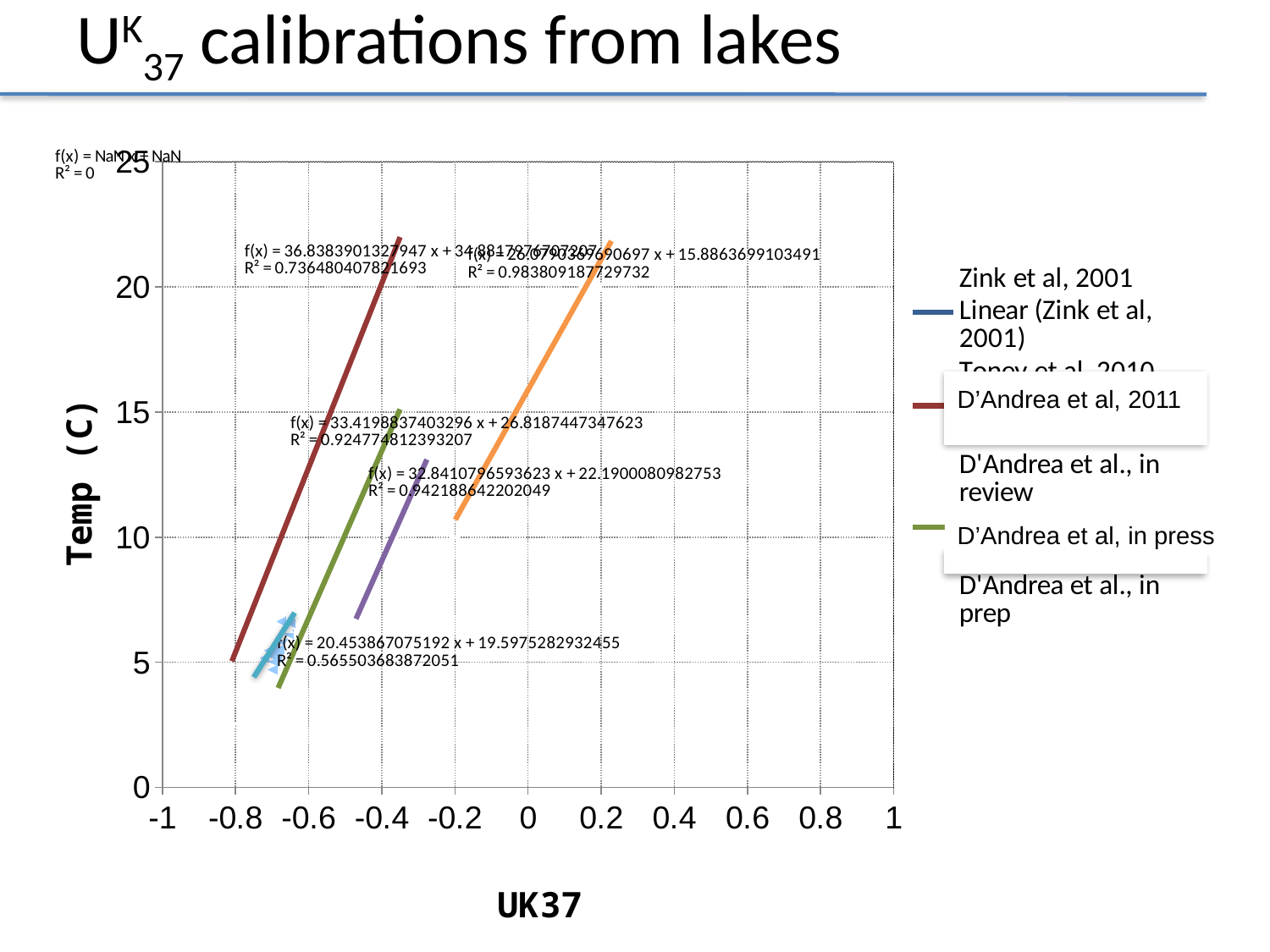
What kind of chart is shown on the slide? Scatter chart with linear trend lines Is the lowest temperature reached by the purple trend line greater or less than 5? greater What is the R² value printed for the trend line with equation f(x) = 26.0790369690697 x + 15.8863699103491? 0.983809187729732 What is the label of the x axis? UK37 What is the R² value printed for the trend line with equation f(x) = 20.453867075192 x + 19.5975282932455? 0.565503683872051 What is the maximum value shown on the y axis? 25 Which printed trend line equation has the highest R² value? f(x) = 26.0790369690697 x + 15.8863699103491 Is the highest temperature reached by the orange trend line greater or less than 20? greater What is the R² value printed for the trend line with equation f(x) = 32.8410796593623 x + 22.1900080982753? 0.942188642202049 What is the R² value printed for the trend line with equation f(x) = 33.4198837403296 x + 26.8187447347623? 0.924774812393207 What is the label of the y axis? Temp (C) Is the R² of the trend line f(x) = 36.8383901327947 x + ... larger or smaller than the R² of the trend line f(x) = 32.8410796593623 x + 22.1900080982753? smaller